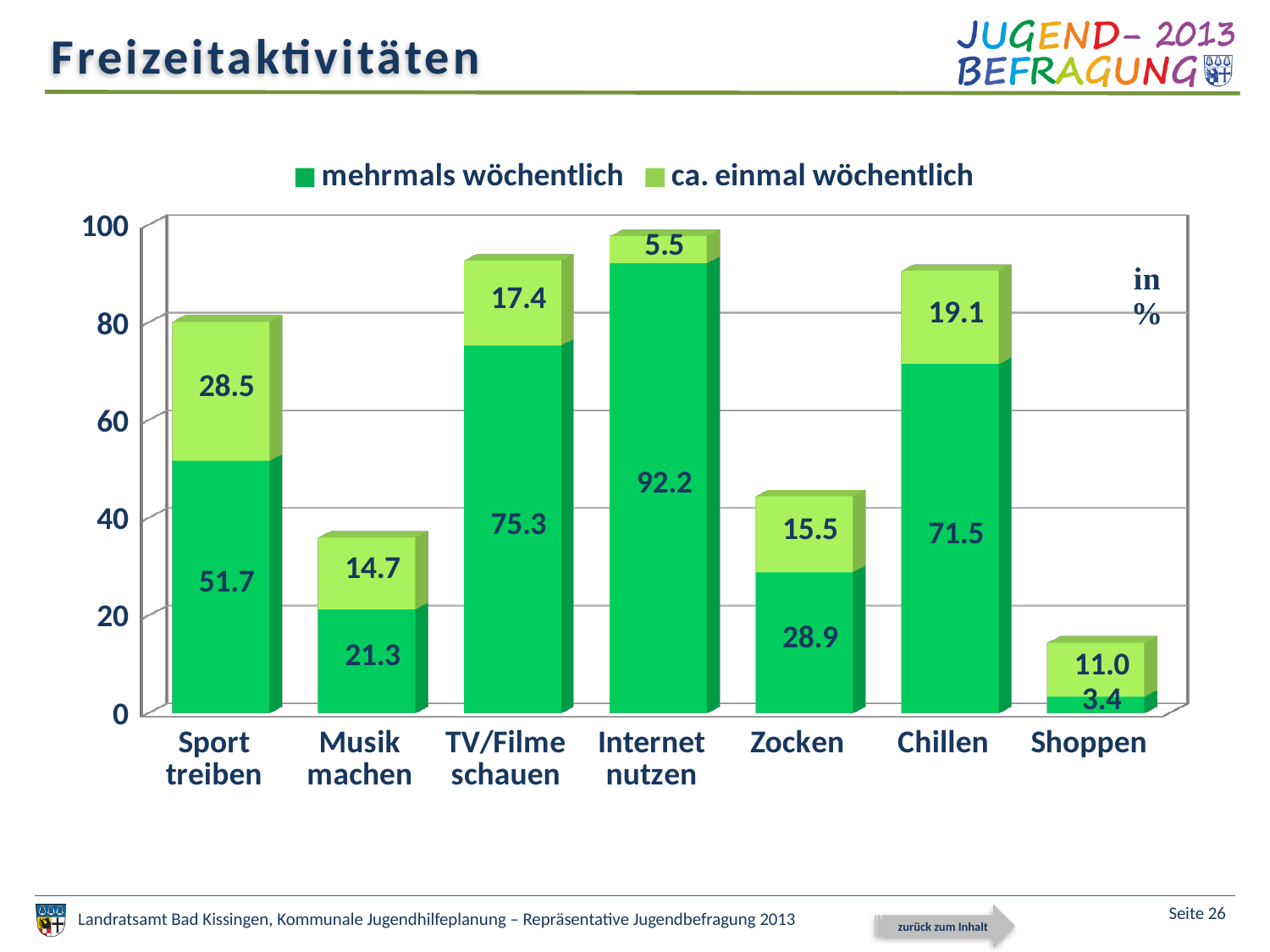
How many series does the legend list? 2 What is the total of the stacked bar for Sport treiben? 80.2 Which category has the lowest value for "ca. einmal wöchentlich"? Internet nutzen Which is larger for "mehrmals wöchentlich": Musik machen or Zocken? Zocken How many categories are shown on the x axis? 7 What kind of chart is shown on the slide? Stacked bar chart What is the value for "mehrmals wöchentlich" for Internet nutzen? 92.2 What is the value for "ca. einmal wöchentlich" for Sport treiben? 28.5 Which category has the highest value for "mehrmals wöchentlich"? Internet nutzen What is the total of the stacked bar for Shoppen? 14.4 What is the difference between the "mehrmals wöchentlich" values for TV/Filme schauen and Chillen? 3.8 What is the value for "mehrmals wöchentlich" for Shoppen? 3.4